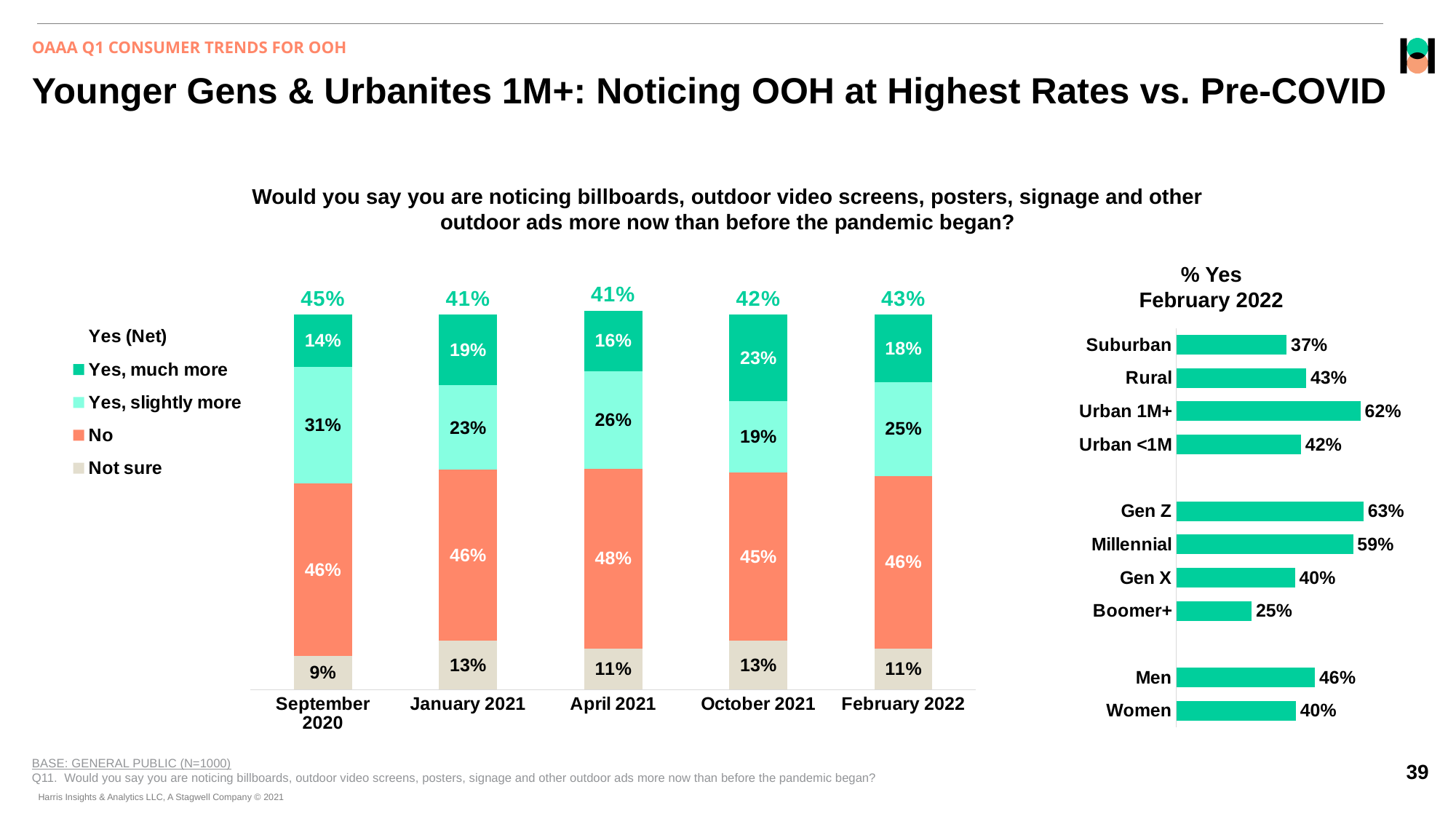
In the "% Yes February 2022" chart on the right, which category has the highest value? Gen Z In the "% Yes February 2022" chart on the right, what is the value for Urban 1M+? 62% In the stacked bar chart on the left, how many time periods are shown on the x axis? 5 In the stacked bar chart on the left, what percentage answered "Yes, much more" in October 2021? 23% In the stacked bar chart on the left, which time period has the highest "Yes (Net)" value? September 2020 In the stacked bar chart on the left, what is the difference between the "Yes, slightly more" values for September 2020 and January 2021? 8% What kind of chart is the "% Yes February 2022" chart on the right? Bar chart In the stacked bar chart on the left, what is the "Yes (Net)" value for September 2020? 45% In the stacked bar chart on the left, how many response categories does the legend list (excluding Yes (Net))? 4 In the stacked bar chart on the left, what percentage answered "No" in April 2021? 48% In the "% Yes February 2022" chart on the right, which category has the lowest value? Boomer+ In the "% Yes February 2022" chart on the right, what is the difference between Men and Women? 6%